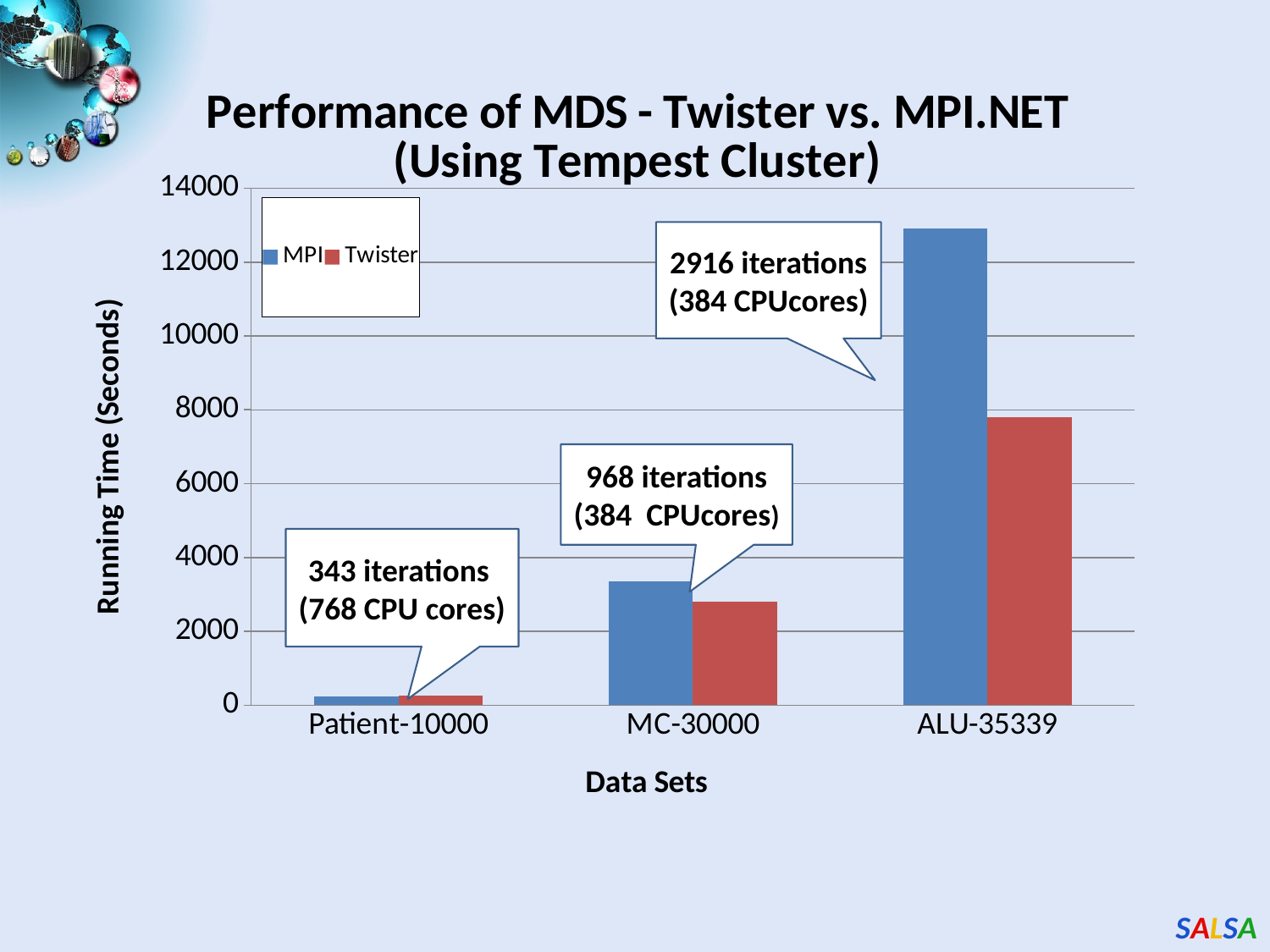
What is the label of the y axis? Running Time (Seconds) Is the MPI running time for ALU-35339 greater or less than 12000? greater Which data set has the lowest Twister running time? Patient-10000 Do the MPI running times rise or fall moving from Patient-10000 to ALU-35339 along the x axis? rise For ALU-35339, which series has the larger running time, MPI or Twister? MPI Is the MPI running time for MC-30000 greater or less than 4000? less For MC-30000, which series has the larger running time, MPI or Twister? MPI What kind of chart is shown on the slide? Bar chart How many data sets (categories) are shown on the x axis? 3 Which data set has the highest MPI running time? ALU-35339 How many series does the legend list? 2 Is the Twister running time for ALU-35339 greater or less than 6000? greater